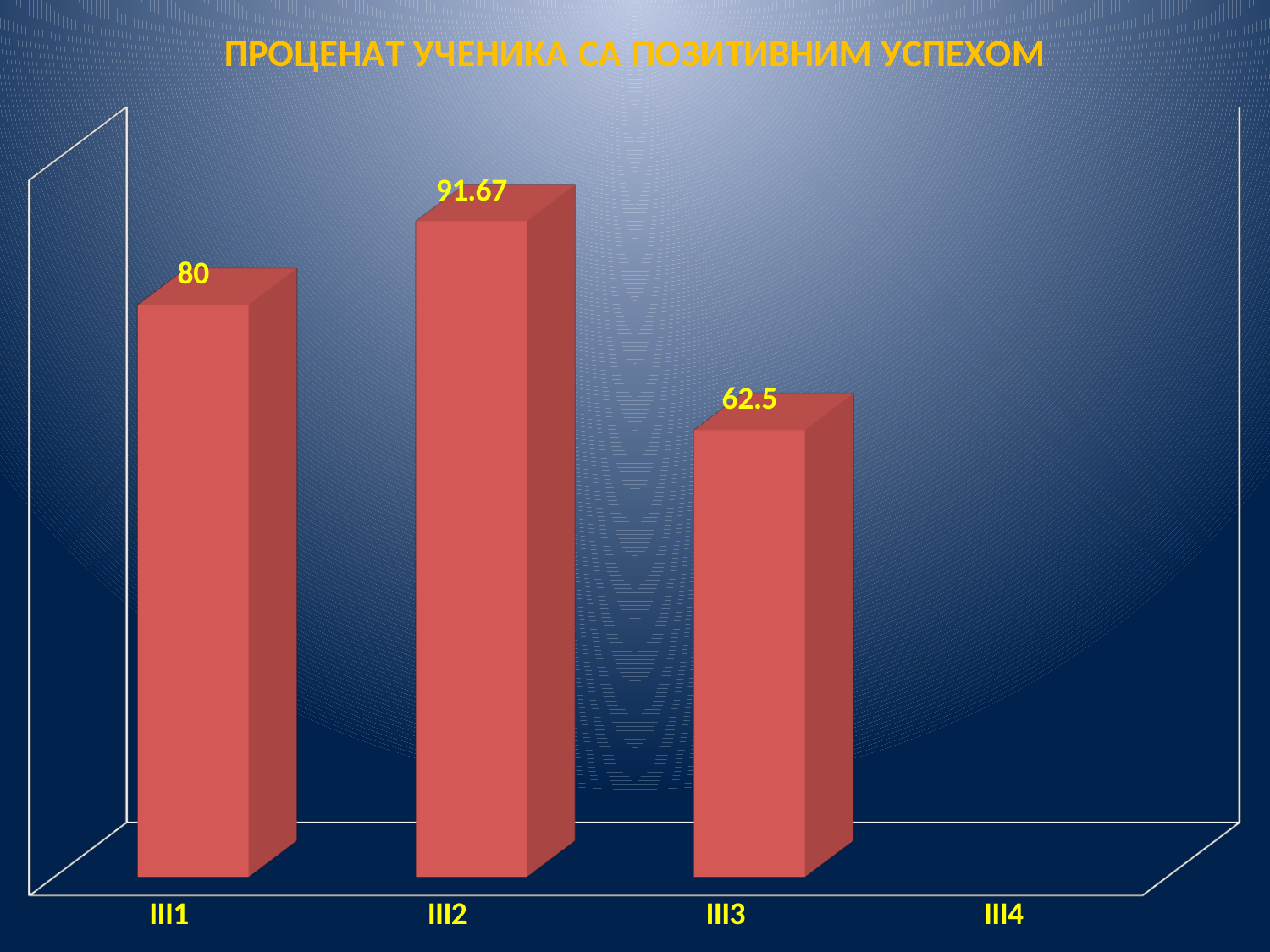
How many bars are plotted on the chart? 3 What is the value for III2? 91.67 What is the difference between the values for III2 and III3? 29.17 What kind of chart is shown on the slide? bar chart What is the title of the chart? ПРОЦЕНАТ УЧЕНИКА СА ПОЗИТИВНИМ УСПЕХОМ Which is larger, the value for III1 or the value for III3? III1 What is the difference between the values for III1 and III3? 17.5 What is the difference between the values for III2 and III1? 11.67 Which category with a plotted bar has the lowest value? III3 What is the value for III1? 80 What is the value for III3? 62.5 Which category has the highest value? III2